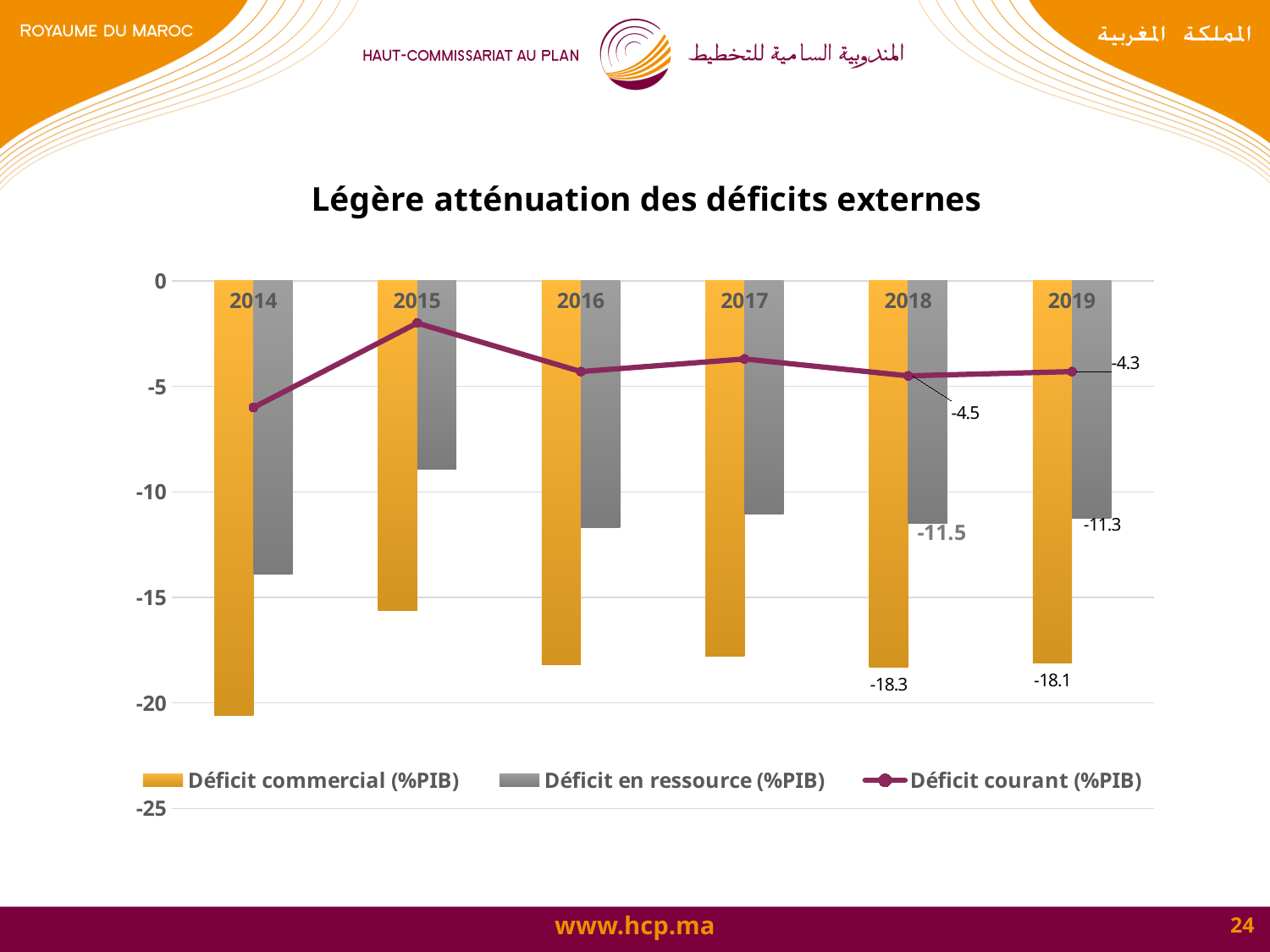
What is the value of Déficit commercial (%PIB) for 2019? -18.1 What is the value of Déficit commercial (%PIB) for 2018? -18.3 What is the value of Déficit courant (%PIB) for 2018? -4.5 Is the Déficit commercial (%PIB) value for 2016 greater or less than -15? less What is the value of Déficit en ressource (%PIB) for 2019? -11.3 In which year is the Déficit courant (%PIB) line at its highest (least negative) point? 2015 In which year is the Déficit commercial (%PIB) bar at its lowest (most negative) value? 2014 Is the Déficit en ressource (%PIB) value for 2015 greater or less than -10? greater How many series does the legend list? 3 What is the title of the chart? Légère atténuation des déficits externes How many years are shown on the x axis of the chart? 6 What is the difference between the Déficit en ressource (%PIB) values for 2018 and 2019? 0.2